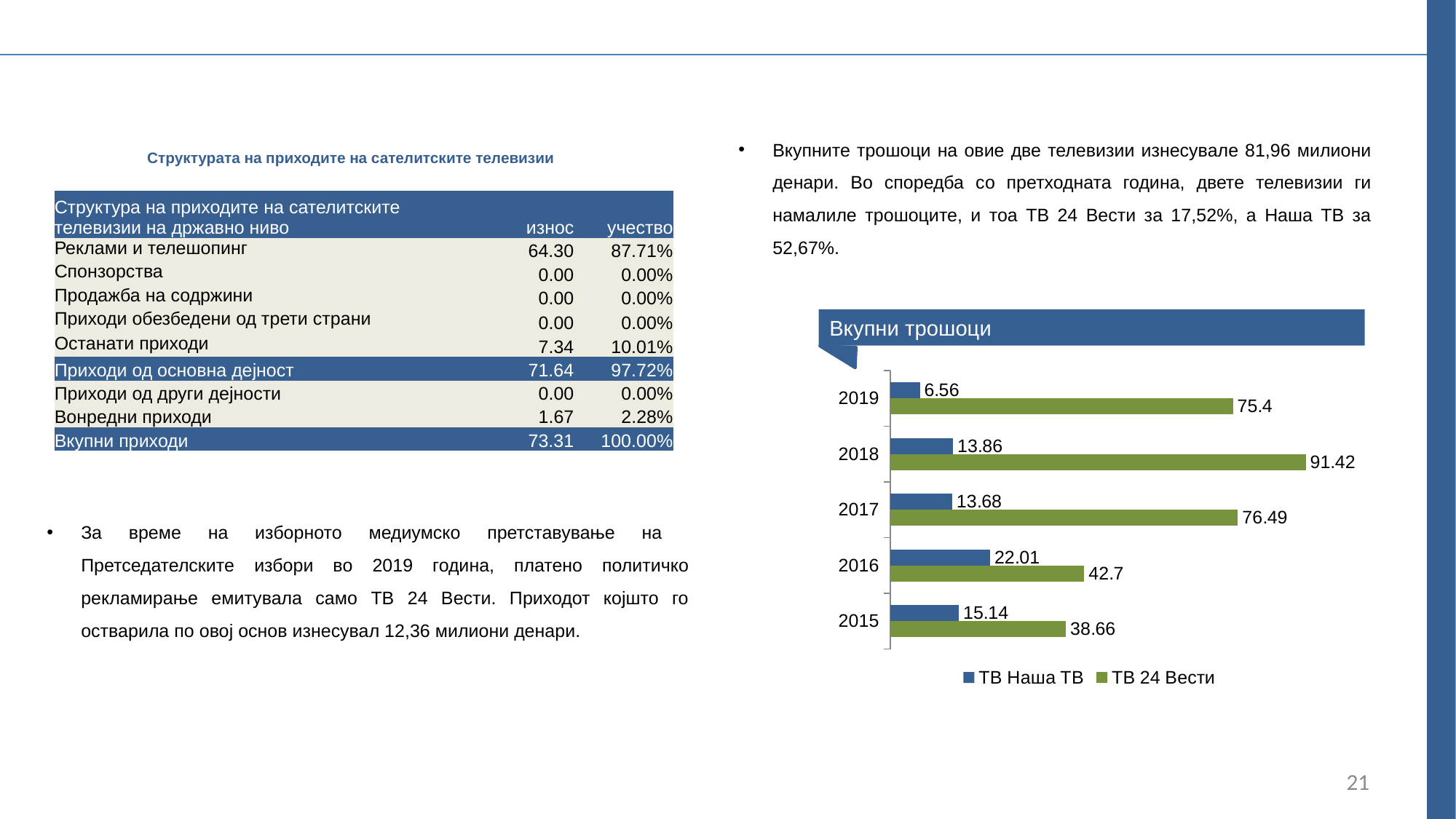
How many years are shown on the "Вкупни трошоци" chart? 5 In which year is the value for ТВ Наша ТВ lowest on the "Вкупни трошоци" chart? 2019 In which year is the value for ТВ Наша ТВ highest on the "Вкупни трошоци" chart? 2016 What is the value for ТВ Наша ТВ in 2019 on the "Вкупни трошоци" chart? 6.56 What is the value for ТВ 24 Вести in 2018 on the "Вкупни трошоци" chart? 91.42 How many series does the legend of the "Вкупни трошоци" chart list? 2 Which series is shown in green on the "Вкупни трошоци" chart? ТВ 24 Вести What is the difference between the ТВ 24 Вести and ТВ Наша ТВ values in 2019 on the "Вкупни трошоци" chart? 68.84 What is the value for ТВ 24 Вести in 2015 on the "Вкупни трошоци" chart? 38.66 What kind of chart is shown under the title "Вкупни трошоци"? bar chart In which year is the value for ТВ 24 Вести highest on the "Вкупни трошоци" chart? 2018 Which series has the larger value in 2016 on the "Вкупни трошоци" chart, ТВ Наша ТВ or ТВ 24 Вести? ТВ 24 Вести